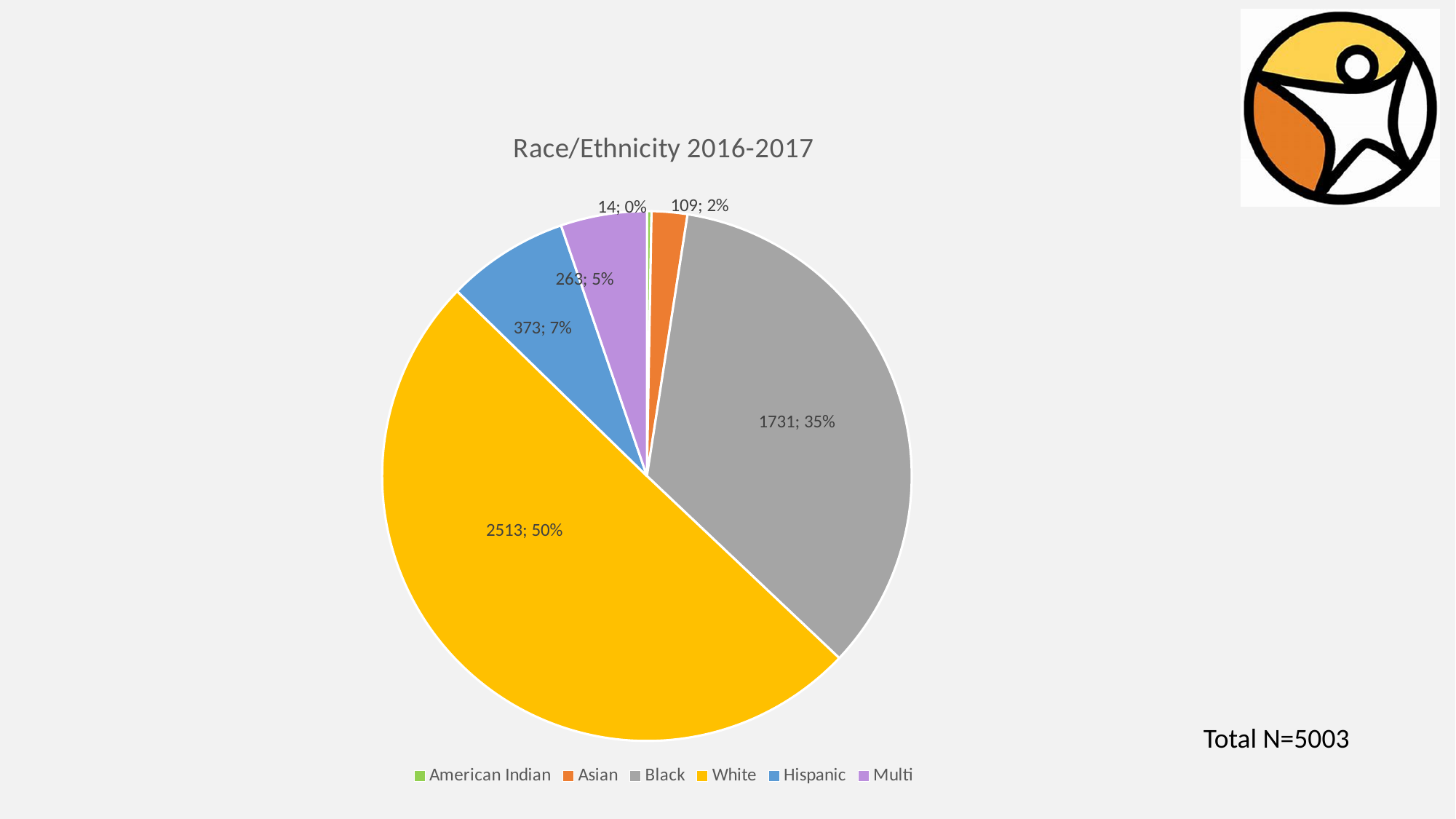
What is the count for Hispanic? 373 What is the count for Black? 1731 How many categories does the legend list? 6 What is the difference between the counts for White and Black? 782 What is the count for Asian? 109 What percentage share of the pie does Multi have? 5% What is the count for White? 2513 Which category has the smallest slice? American Indian What is the title of the chart? Race/Ethnicity 2016-2017 What percentage share of the pie does White have? 50% Which category has the largest slice? White What kind of chart is shown on the slide? pie chart